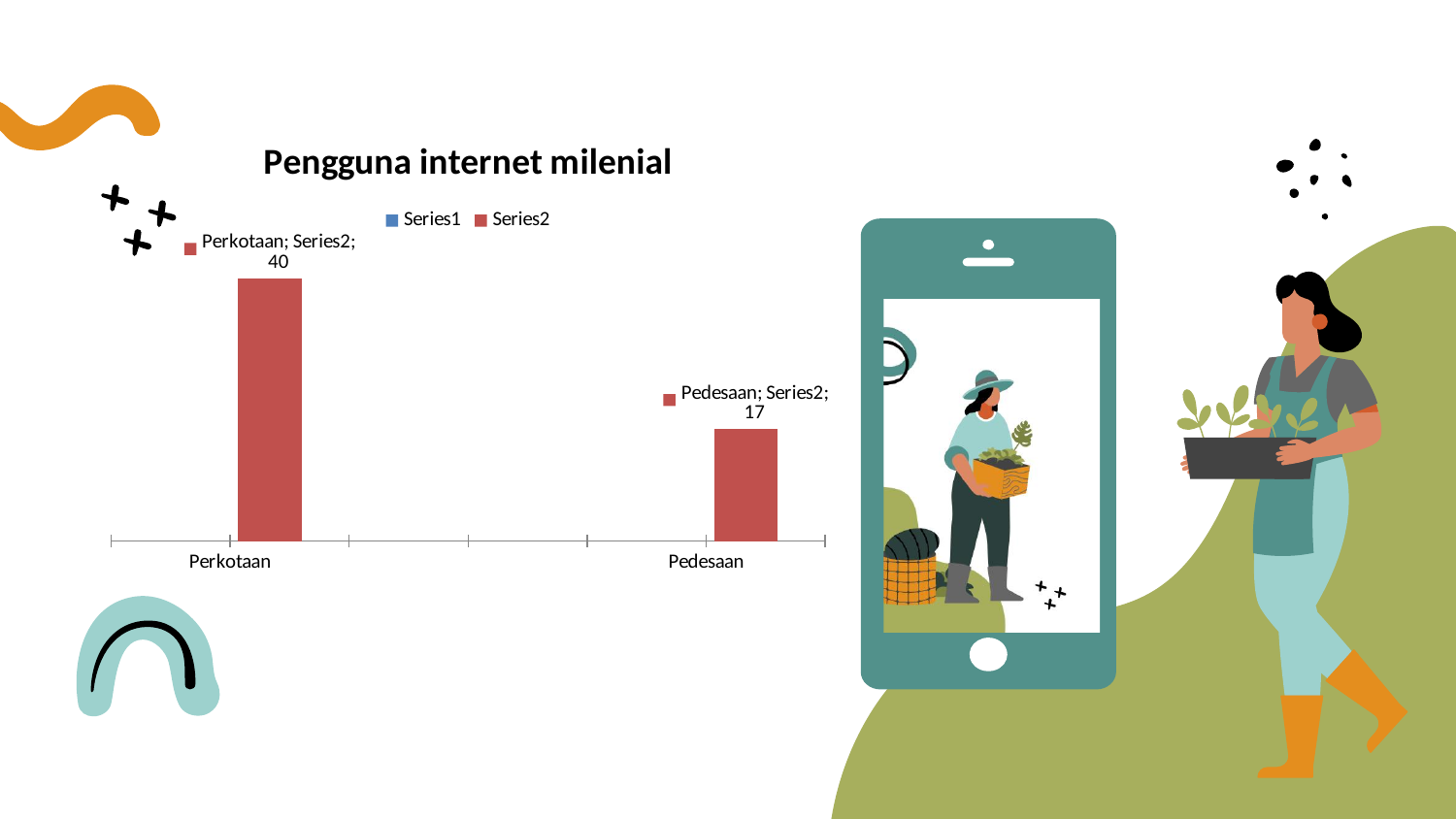
How many categories are shown on the x axis? 2 Which category has the highest Series2 value? Perkotaan What is the title of the chart? Pengguna internet milenial Do the Series2 values rise or fall from Perkotaan to Pedesaan? Fall Which has a larger Series2 value, Perkotaan or Pedesaan? Perkotaan What is the Series2 value for Pedesaan? 17 What is the difference between the Series2 values for Perkotaan and Pedesaan? 23 What kind of chart is shown on the slide? Bar chart What is the Series2 value for Perkotaan? 40 How many series does the legend list? 2 Which category has the lowest Series2 value? Pedesaan What colour are the Series2 bars? Red